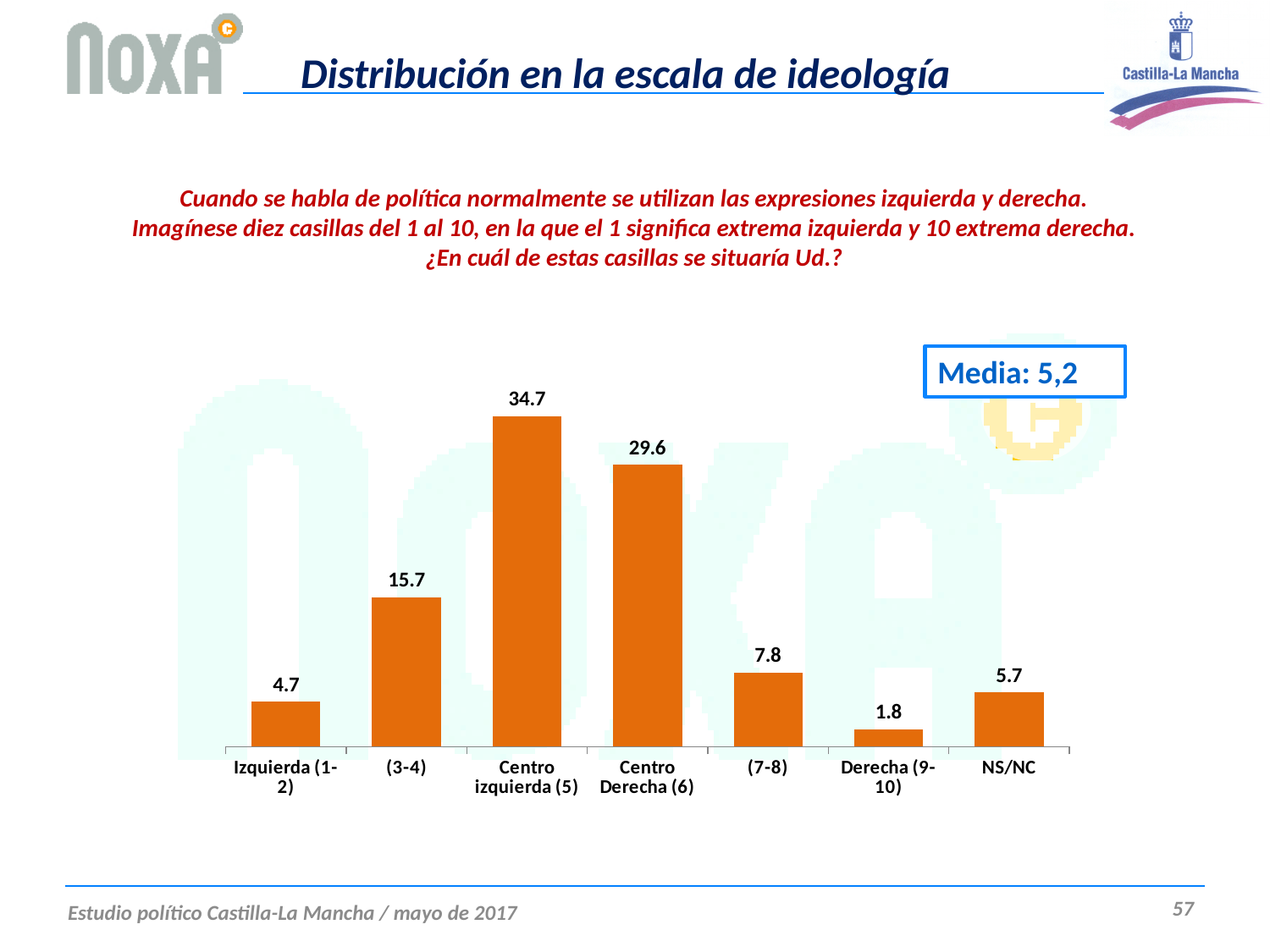
What is the value for Centro izquierda (5)? 34.7 Which category has the highest value? Centro izquierda (5) What is the difference between the values for Centro izquierda (5) and Centro Derecha (6)? 5.1 What is the value for Izquierda (1-2)? 4.7 What is the value for NS/NC? 5.7 What is the value for Derecha (9-10)? 1.8 How many categories are shown on the x axis? 7 Which category has the lowest value? Derecha (9-10) What kind of chart is shown on the slide? Bar chart Which is larger, the value for (3-4) or the value for (7-8)? (3-4) What is the mean (Media) value shown in the box on the chart? 5,2 What is the difference between the values for (3-4) and (7-8)? 7.9